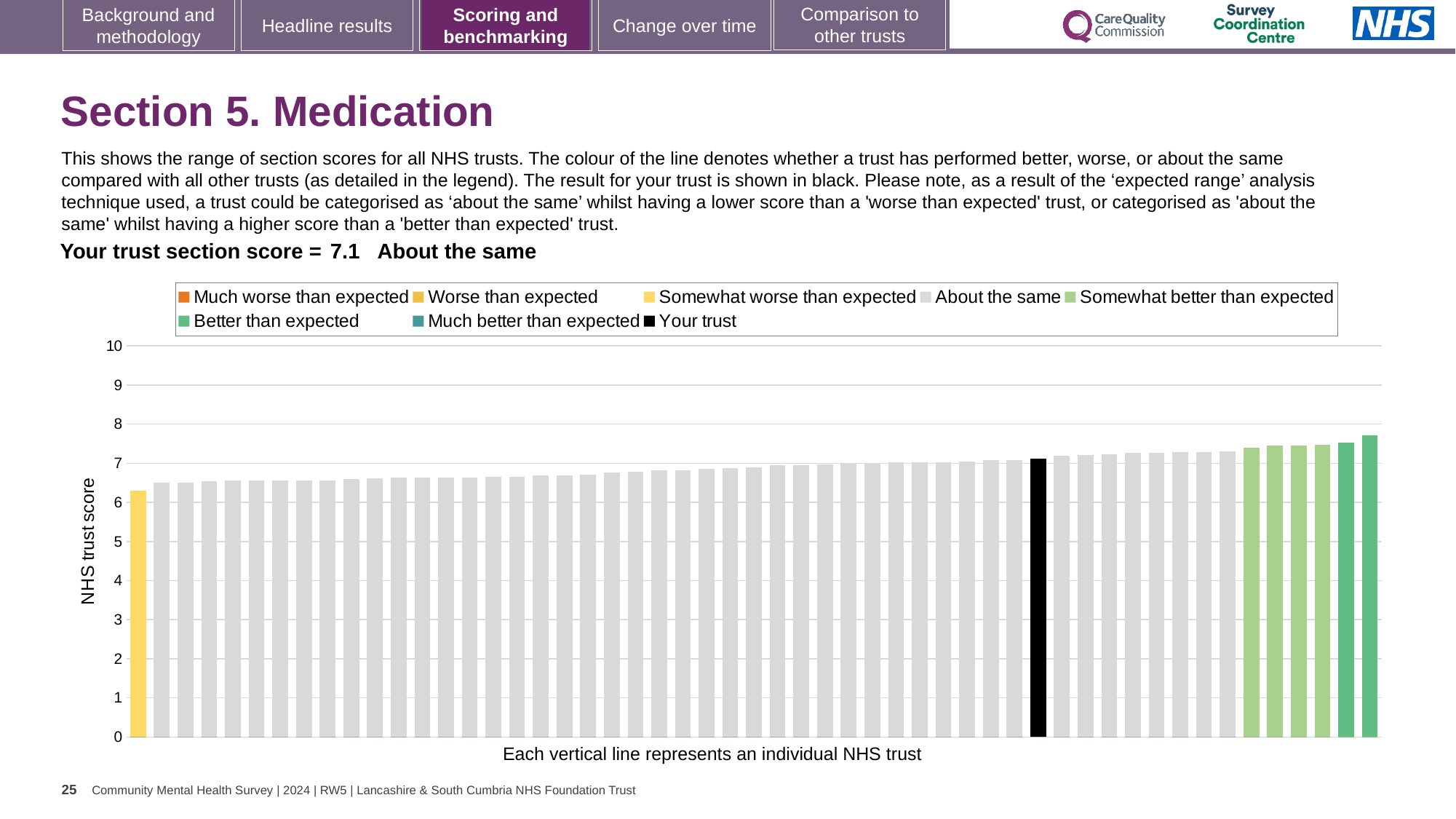
How many entries does the chart legend list? 8 What is the label on the vertical axis of the chart? NHS trust score Is the value for the leftmost (yellow) bar greater or less than 7? less Which is larger: the value of the black 'Your trust' bar or the value of the leftmost yellow bar? The black 'Your trust' bar How many bars in the chart are coloured in a shade of green? 6 Which bar has the lowest NHS trust score? The leftmost (yellow) bar Do the bar values rise or fall from left to right along the x axis? rise Is the value for the black 'Your trust' bar greater or less than 8? less What kind of chart is shown on the slide? Bar chart Is the value for the rightmost bar greater or less than 7? greater Which bar has the highest NHS trust score? The rightmost bar What is the section score for your trust shown on the slide? 7.1